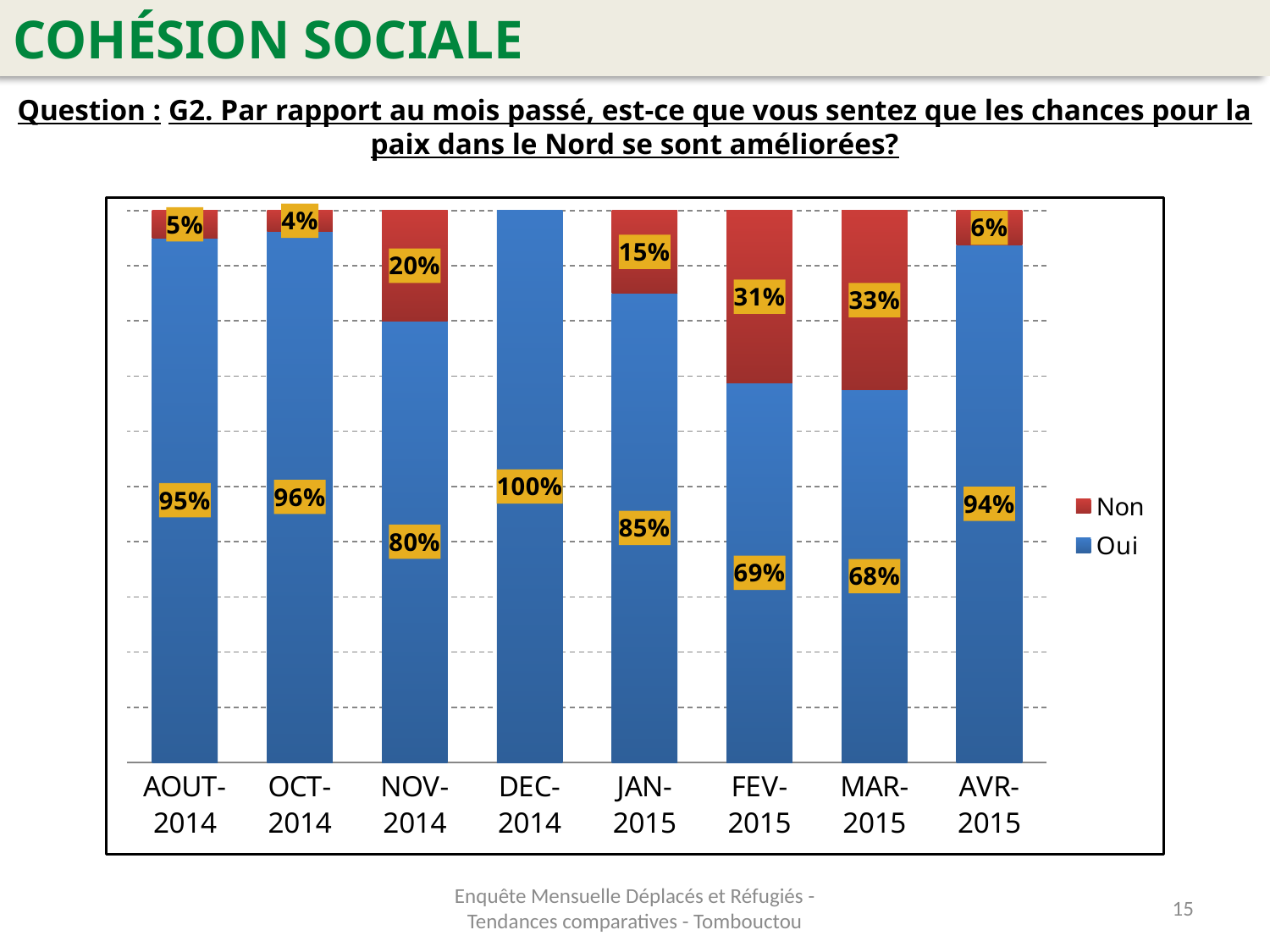
What kind of chart is shown on the slide? stacked bar chart What is the value for Non in AVR-2015? 6% Which month has the highest value for Non? MAR-2015 What is the value for Oui in NOV-2014? 80% What is the difference between the Oui values for OCT-2014 and FEV-2015? 27% How many series does the legend list? 2 How many months are shown on the x axis? 8 Which colour represents the Non series? red Which is larger, the Non value for NOV-2014 or the Non value for JAN-2015? NOV-2014 What is the value for Non in MAR-2015? 33% What is the value for Oui in DEC-2014? 100% Which month has the lowest value for Oui? MAR-2015